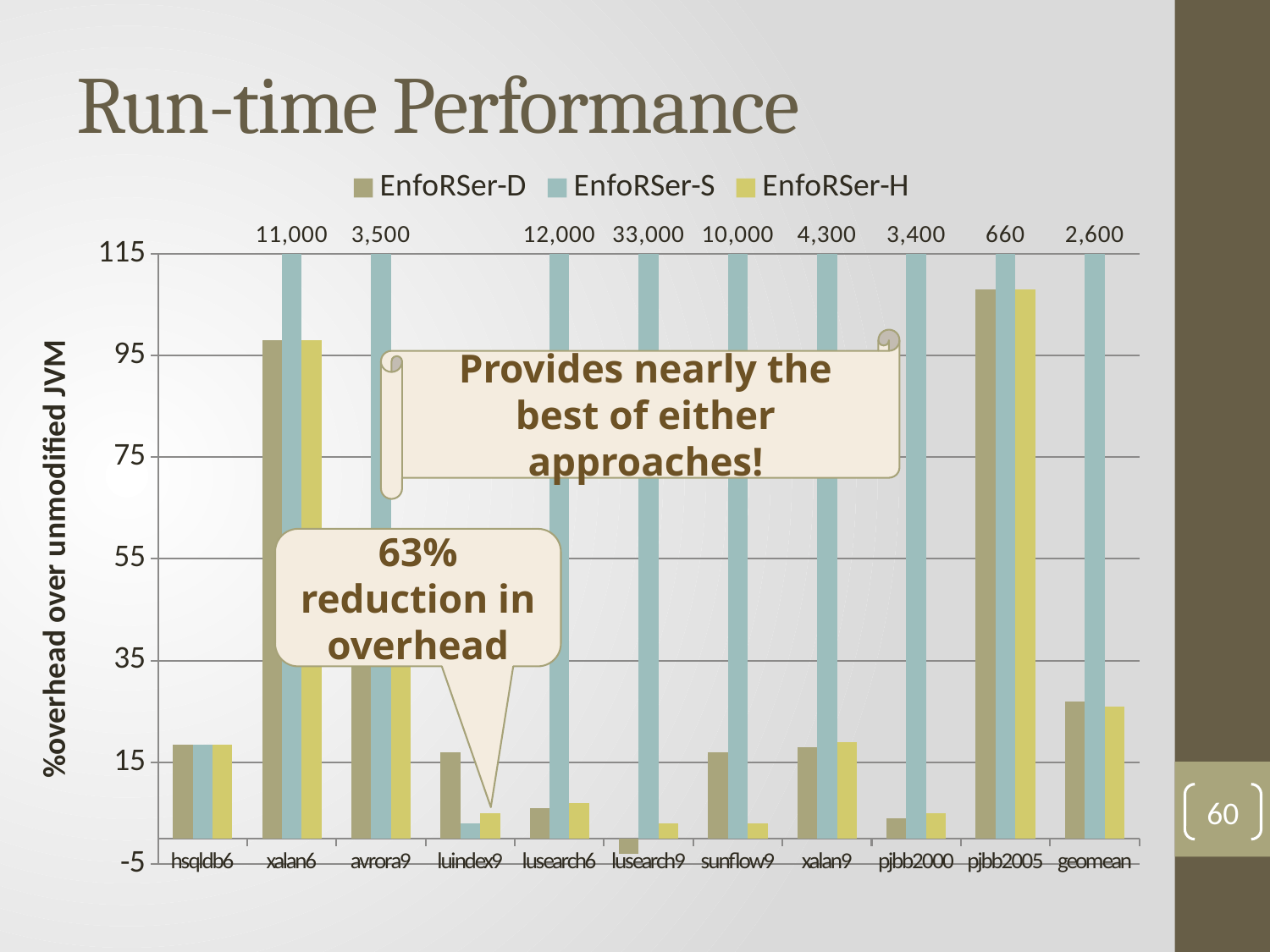
What is the difference between the EnfoRSer-S values for lusearch9 and lusearch6? 21,000 How many benchmark categories are shown on the x axis? 11 What is the EnfoRSer-S value printed for lusearch9? 33,000 Is the EnfoRSer-H value for geomean greater or less than 35? less Is the EnfoRSer-D value for pjbb2005 greater or less than 95? greater What kind of chart is shown on the slide? bar chart Which is larger, the EnfoRSer-S value for sunflow9 or for xalan9? sunflow9 Which category has the highest EnfoRSer-S value? lusearch9 What is the label of the y axis? %overhead over unmodified JVM Which category has the lowest EnfoRSer-D value? lusearch9 How many series does the legend list? 3 What is the EnfoRSer-S value printed for pjbb2005? 660